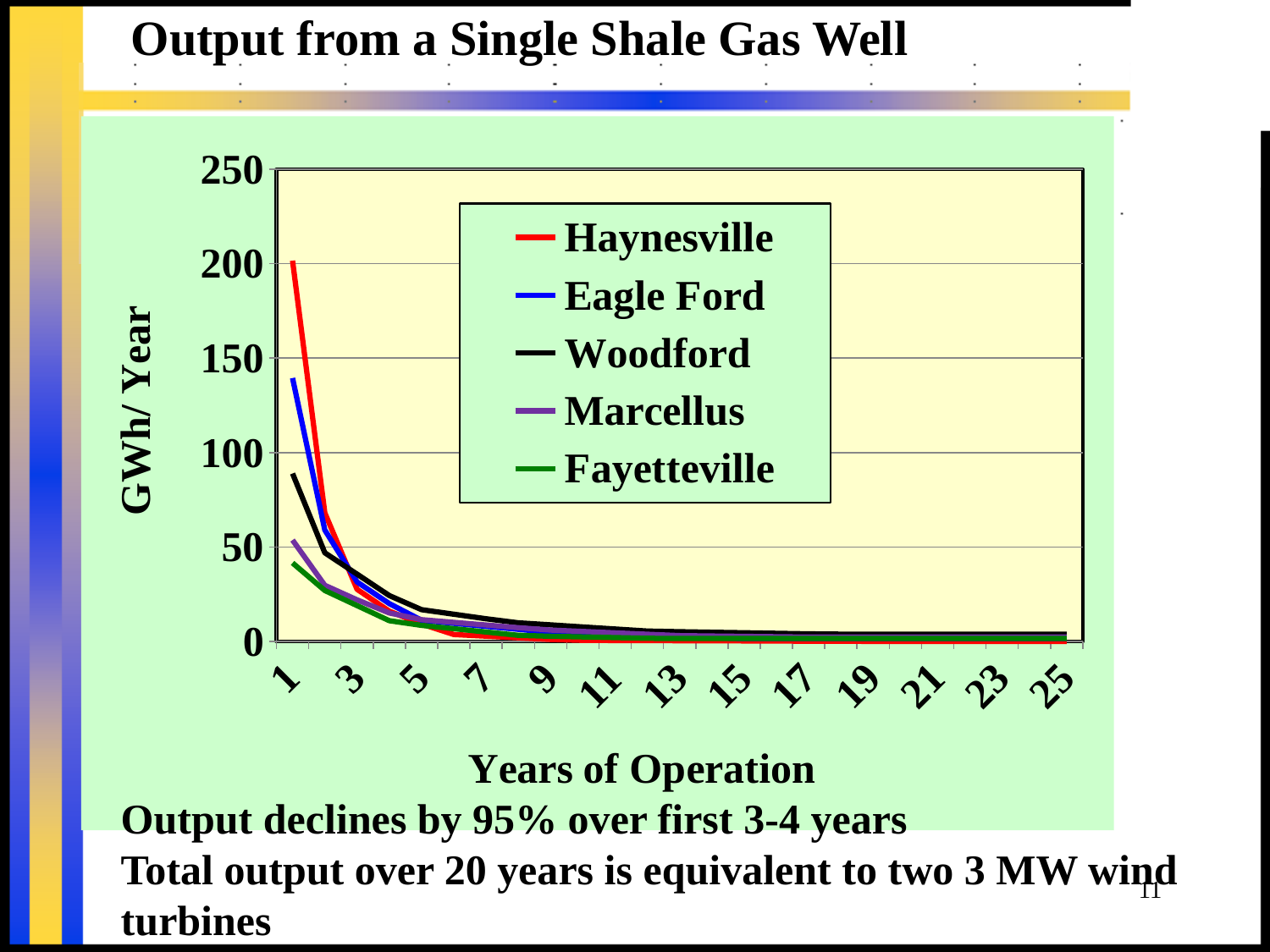
Is the value for Eagle Ford in year 1 greater or less than 150 GWh/Year? less In year 1, which is larger: the output of Eagle Ford or Woodford? Eagle Ford Which series has the highest output in year 1? Haynesville Do the output values rise or fall as the years of operation increase? fall Is the value for Woodford in year 1 greater or less than 100 GWh/Year? less Which series has the lowest output in year 1? Fayetteville What kind of chart is shown on the slide? line chart How many series does the legend list? 5 Is the value for Fayetteville in year 1 greater or less than 50 GWh/Year? less What is the label of the y axis? GWh/ Year What is the title of the chart? Output from a Single Shale Gas Well